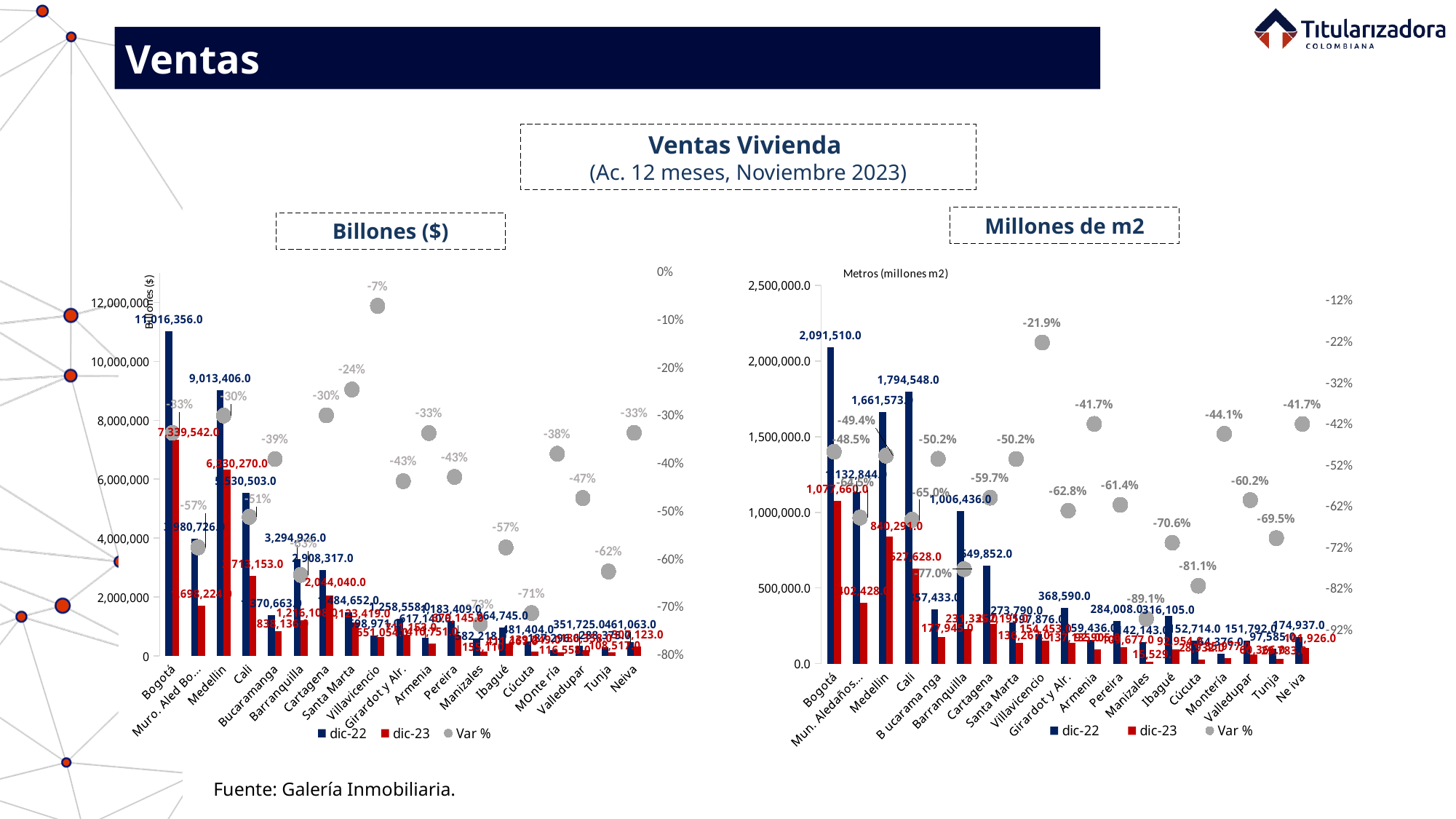
In the Millones de m2 chart, what is the dic-22 value for Bogotá? 2,091,510.0 In the Billones ($) chart, what is the dic-22 value for Bogotá? 11,016,356.0 In the Billones ($) chart, what is the dic-23 value for Medellín? 6,330,270.0 In the Billones ($) chart, which city has the highest dic-22 value? Bogotá How many series does the legend of the Millones de m2 chart list? 3 How many cities are shown on the x axis of the Billones ($) chart? 19 In the Billones ($) chart, what is the difference between the dic-22 and dic-23 values for Bogotá? 3,676,814.0 In the Millones de m2 chart, is the dic-22 value for Bucaramanga greater or less than 500,000.0? less In the Millones de m2 chart, which is larger, the dic-22 value for Cali or the dic-22 value for Medellín? Cali In the Millones de m2 chart, what is the Var % for Barranquilla? -77.0% In the Billones ($) chart, is the dic-22 value for Cali greater or less than 4,000,000? greater In the Billones ($) chart, what is the Var % for Villavicencio? -7%